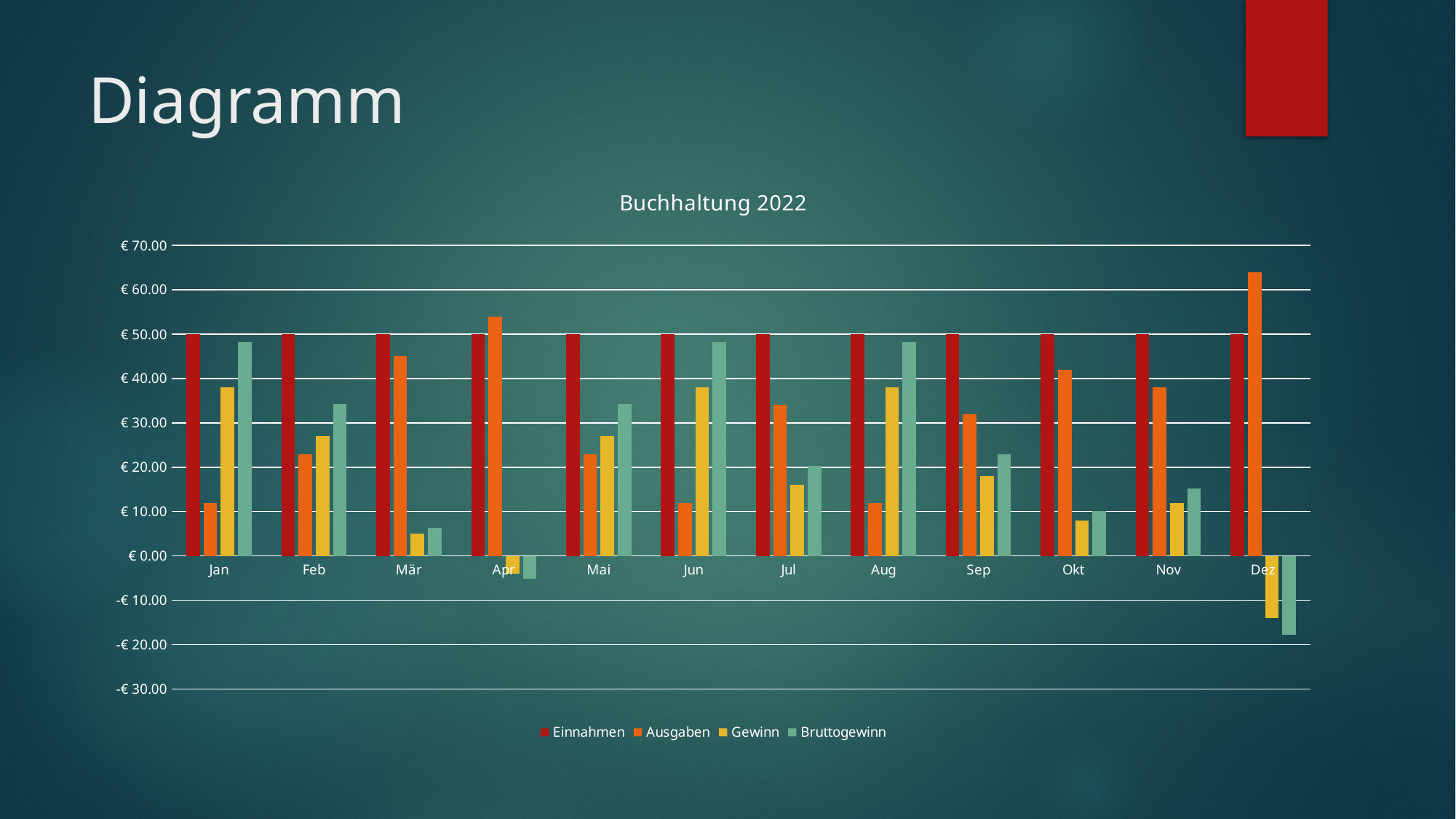
Which month has the lowest Bruttogewinn? Dez How many series does the legend list? 4 What is the title of the chart? Buchhaltung 2022 How many months are shown on the x axis? 12 Is the value of Bruttogewinn for Dez greater or less than -€ 10.00? less Is the value of Ausgaben for Dez greater or less than € 60.00? greater What is the value of Einnahmen for Jan? € 50.00 Which is larger, Gewinn for Jun or Gewinn for Jul? Gewinn for Jun Which month has the highest Ausgaben? Dez Do the Einnahmen values rise, fall or stay the same from Jan to Dez? stay the same Is the value of Gewinn for Mär greater or less than € 10.00? less What kind of chart is shown on the slide? bar chart